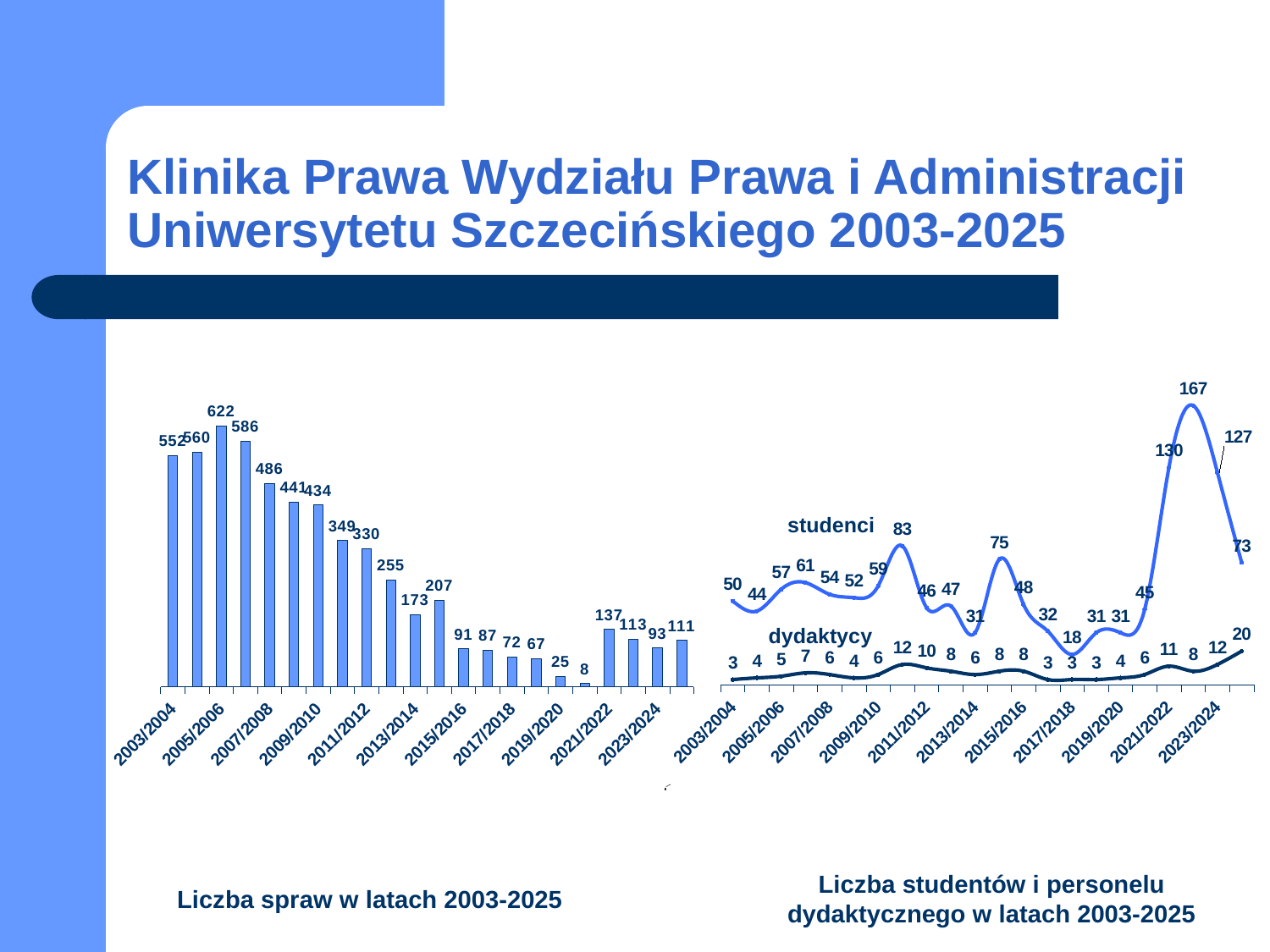
In the right chart, which series has the larger value for 2003/2004, 'studenci' or 'dydaktycy'? studenci In the left chart 'Liczba spraw w latach 2003-2025', what is the lowest value shown? 8 How many series are plotted in the right chart 'Liczba studentów i personelu dydaktycznego w latach 2003-2025'? 2 How many bars are plotted in the left chart 'Liczba spraw w latach 2003-2025'? 22 In the right chart, what is the highest value of the 'studenci' series? 167 What is the title of the right chart? Liczba studentów i personelu dydaktycznego w latach 2003-2025 In the left chart 'Liczba spraw w latach 2003-2025', what is the difference between the highest value (622) and the value for 2003/2004 (552)? 70 In the left chart 'Liczba spraw w latach 2003-2025', what is the highest value shown? 622 In the left chart 'Liczba spraw w latach 2003-2025', what is the value for 2003/2004? 552 What kind of chart is the left chart, 'Liczba spraw w latach 2003-2025'? bar chart In the right chart, what is the highest value of the 'dydaktycy' series? 20 In the right chart, what is the value of the 'studenci' series for 2003/2004? 50